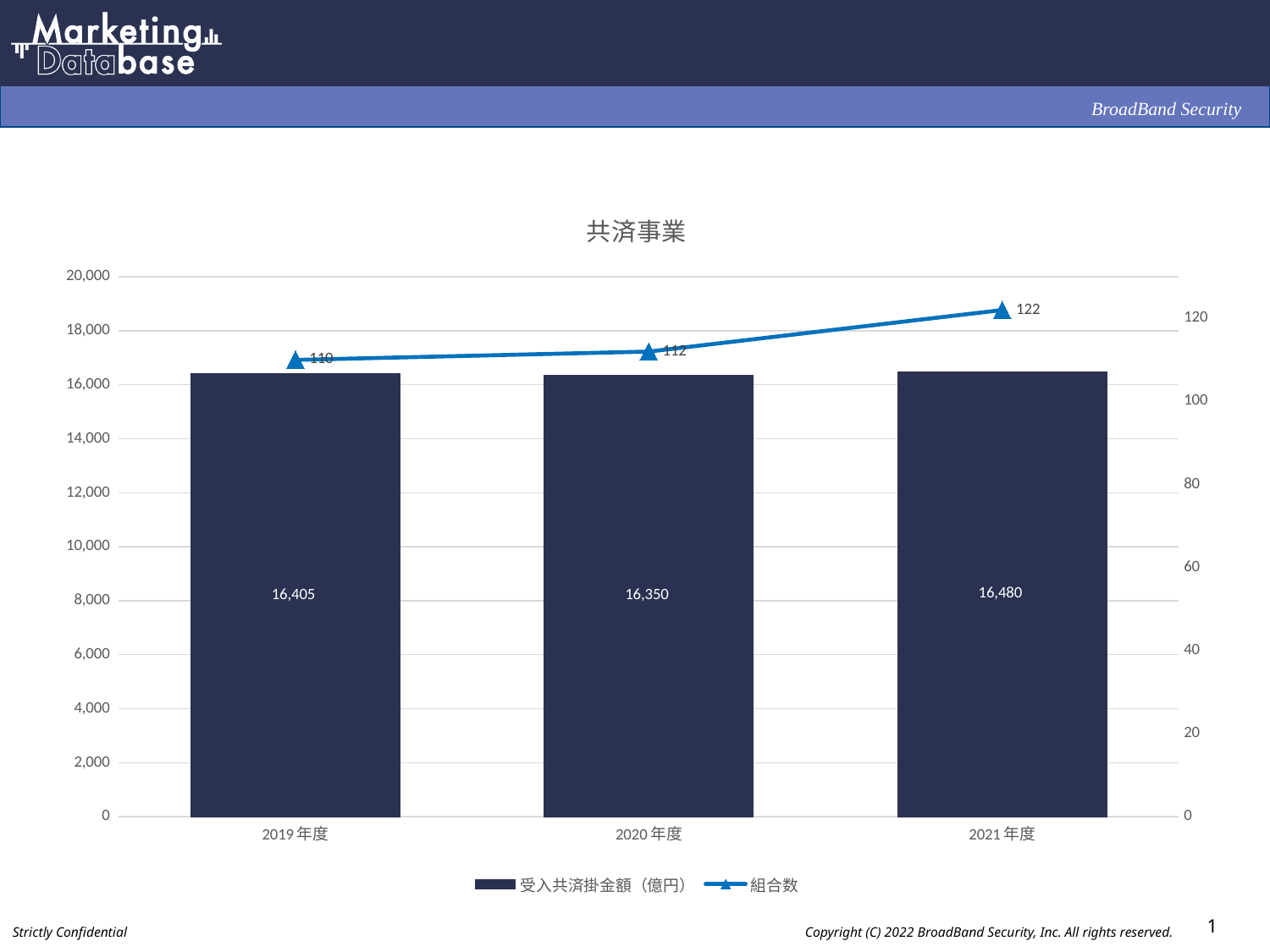
How many years are shown on the x axis? 3 How many series does the legend list? 2 What is the value of 組合数 for 2019年度? 110 Does 組合数 rise or fall from 2019年度 to 2021年度? rise What is the difference in 組合数 between 2021年度 and 2019年度? 12 Which year has the lowest 受入共済掛金額（億円）? 2020年度 Which is larger, the 受入共済掛金額（億円） for 2019年度 or for 2020年度? 2019年度 Which year has the highest 受入共済掛金額（億円）? 2021年度 What is the value of 受入共済掛金額（億円） for 2020年度? 16,350 What is the difference in 受入共済掛金額（億円） between 2021年度 and 2020年度? 130 What is the value of 組合数 for 2021年度? 122 What is the title of the chart? 共済事業